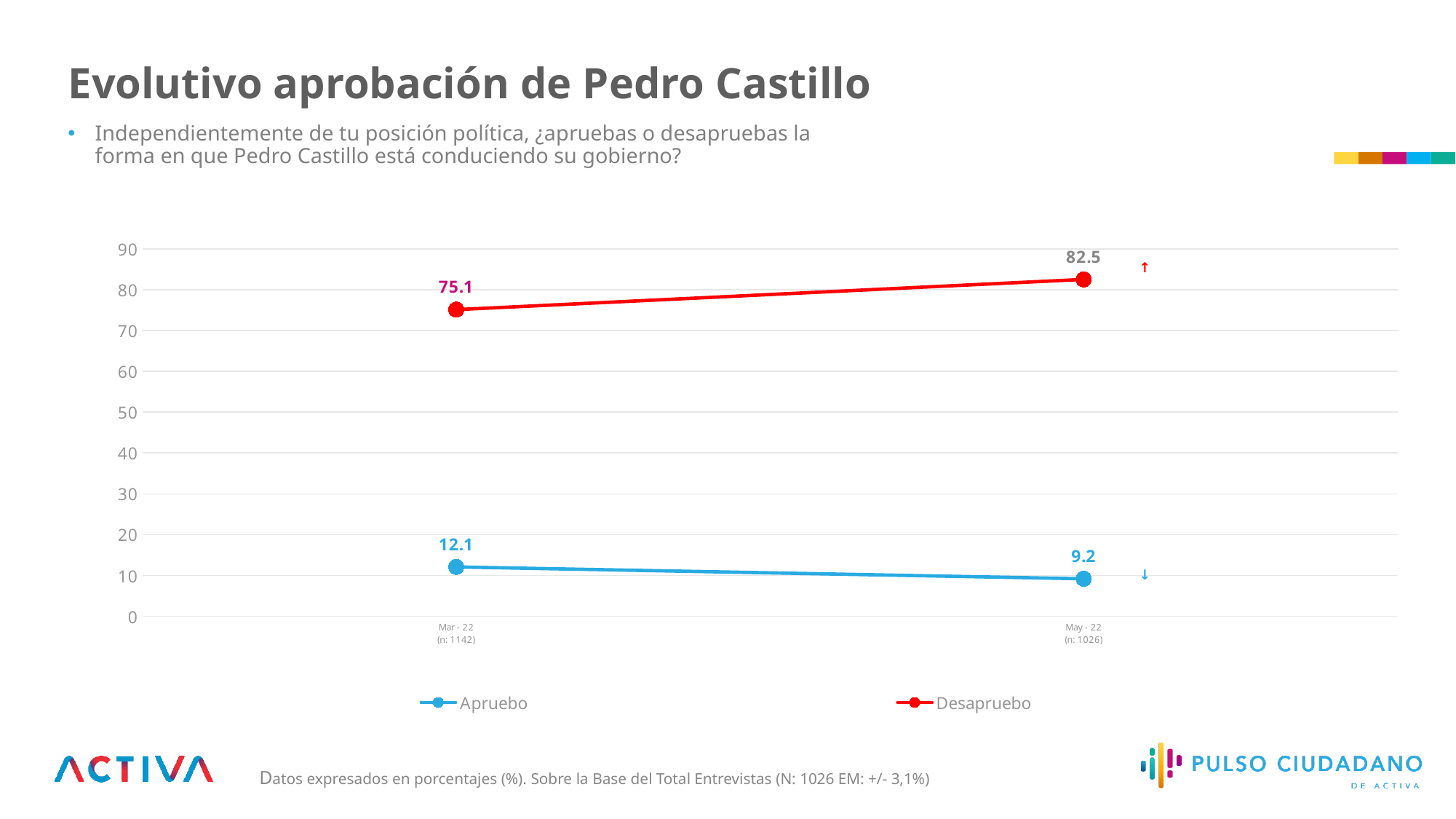
What is the value for Apruebo in Mar - 22? 12.1 How many series does the legend list? 2 Does the Desapruebo series rise or fall from Mar - 22 to May - 22? Rise What is the value for Apruebo in May - 22? 9.2 By how much did Desapruebo change from Mar - 22 to May - 22? 7.4 What is the difference between Desapruebo and Apruebo in May - 22? 73.3 Does the Apruebo series rise or fall from Mar - 22 to May - 22? Fall How many time points are shown on the x axis? 2 What kind of chart is shown on the slide? Line chart What is the value for Desapruebo in Mar - 22? 75.1 What is the value for Desapruebo in May - 22? 82.5 Which series has the higher value in Mar - 22, Apruebo or Desapruebo? Desapruebo